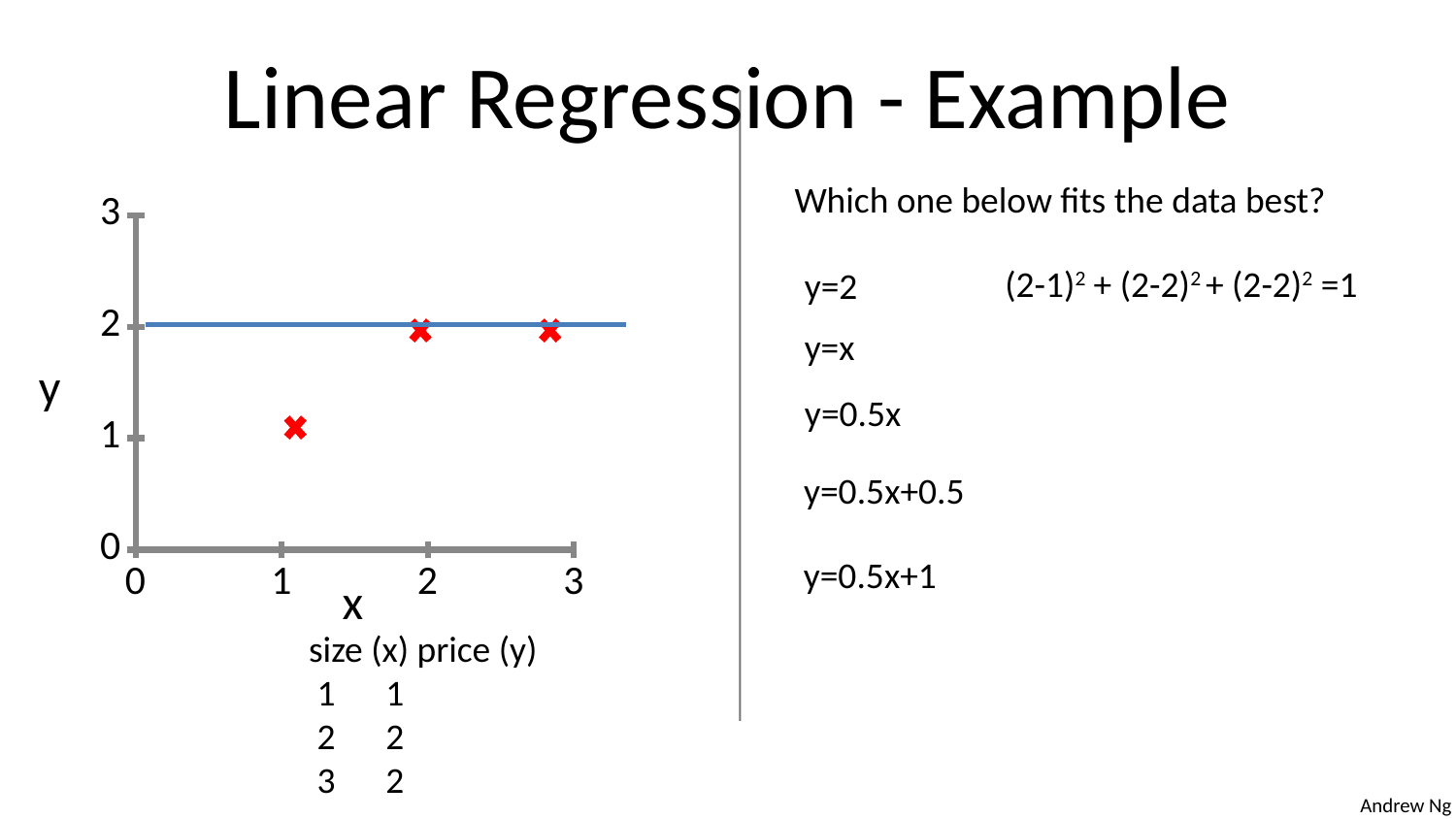
What is the price (y) value for size (x) = 3? 2 Is the price (y) for size (x) = 2 larger than the price (y) for size (x) = 1? yes Is the y value of the point at x = 1 greater or less than 2? less What is the price (y) value for size (x) = 2? 2 Which size (x) value has the lowest price (y)? 1 At what y value is the horizontal blue line drawn on the chart? 2 How many data points are plotted on the chart? 3 Do the y values rise or fall as x increases from 1 to 2? rise What is the difference in price (y) between size (x) = 2 and size (x) = 1? 1 What kind of chart is shown on the slide? scatter chart What is the label on the vertical axis of the chart? y What is the price (y) value for size (x) = 1? 1